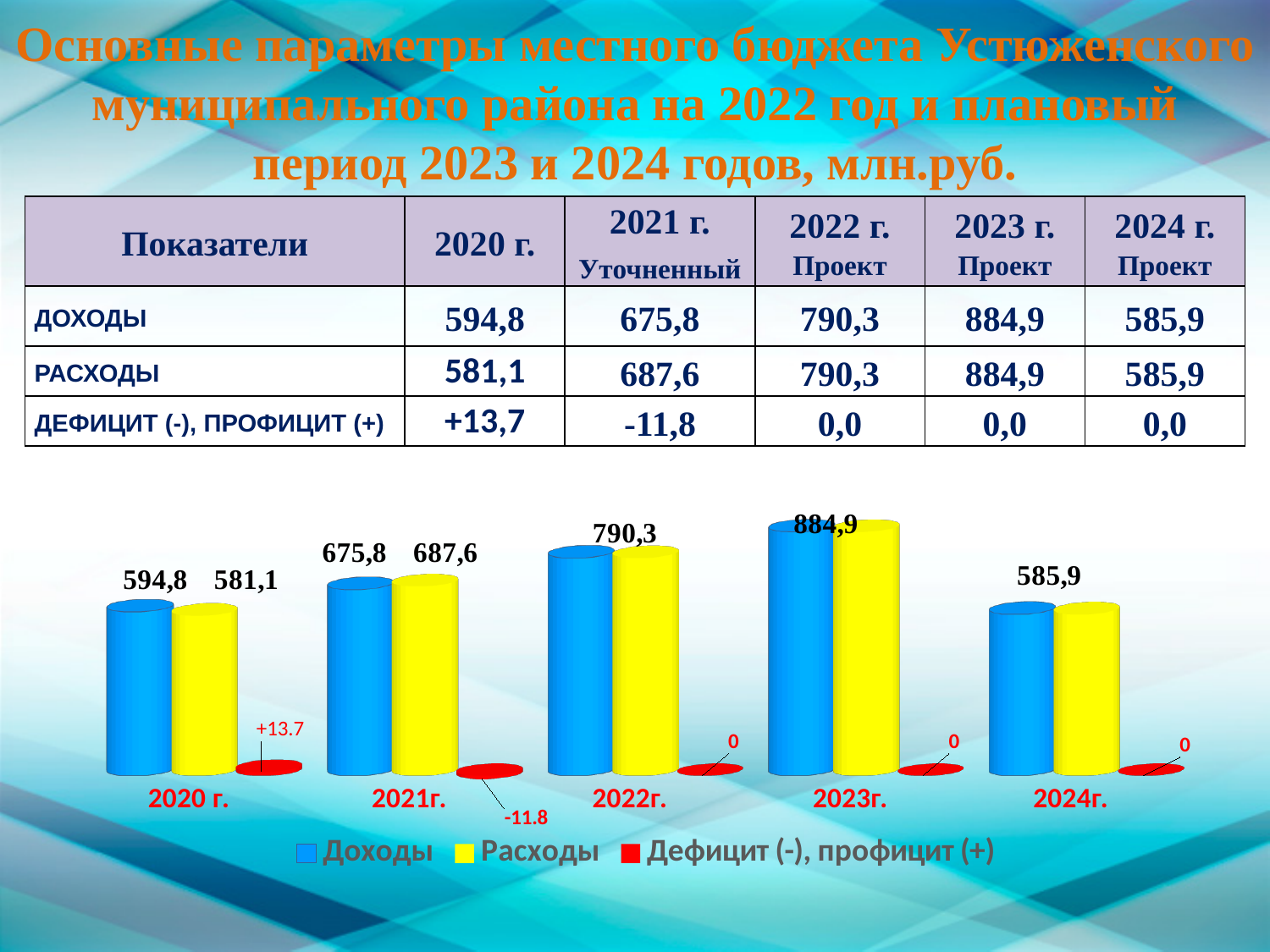
Which year has the highest Доходы value on the chart? 2023г. What is the value of Расходы for 2021г. on the chart? 687,6 Which is larger on the chart for 2020 г., Доходы or Расходы? Доходы How many year categories are shown on the chart's x axis? 5 What is the value labelled for 2023г. on the chart? 884,9 What type of chart is shown on the slide? bar chart How many series does the chart legend list? 3 What is the value of Дефицит (-), профицит (+) for 2021г. on the chart? -11.8 What is the difference between Расходы and Доходы for 2021г. on the chart? 11,8 What colour represents Расходы in the chart legend? yellow Which year has the lowest Расходы value on the chart? 2020 г. What is the value of Доходы for 2020 г. on the chart? 594,8